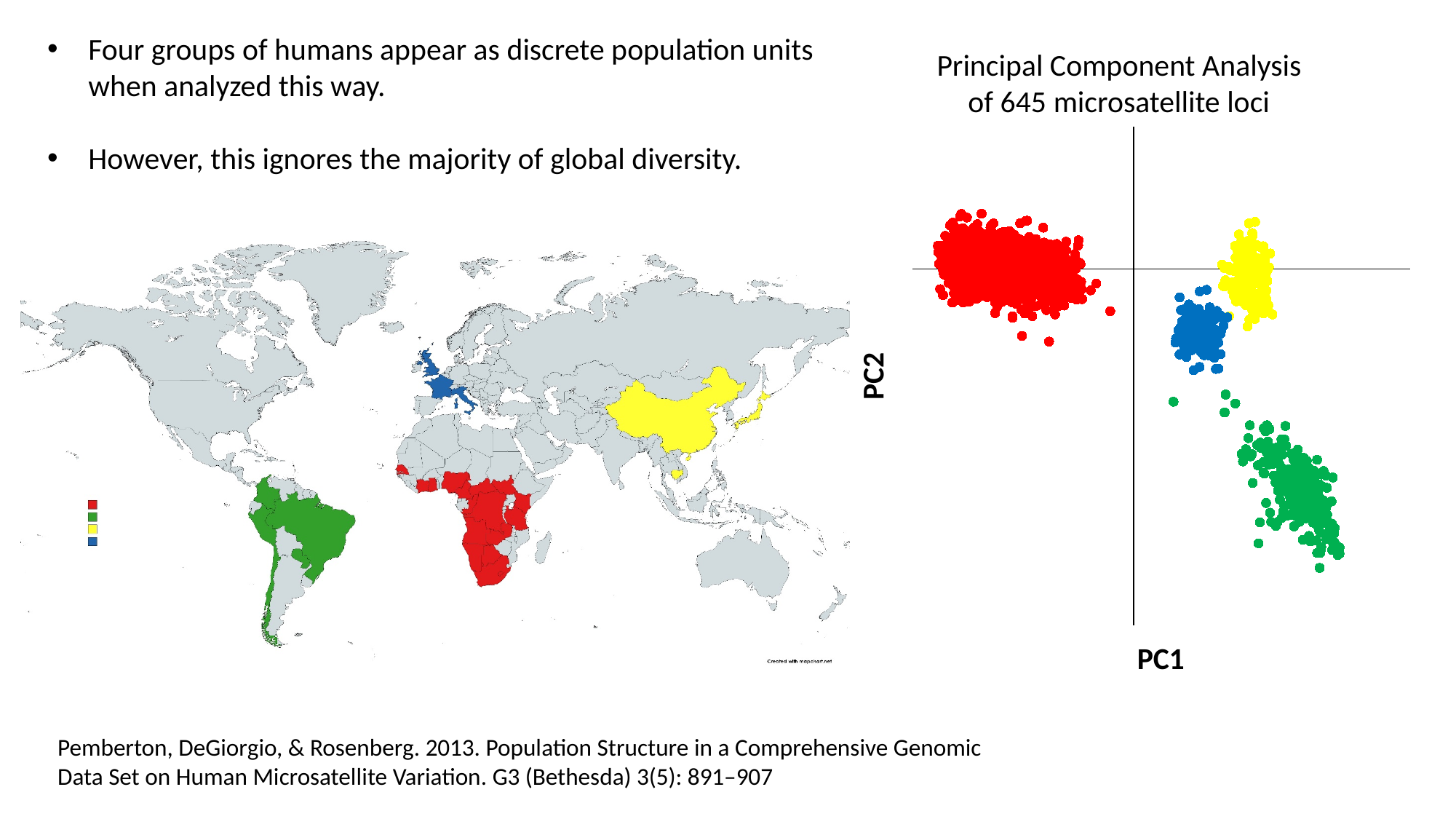
What kind of chart is the Principal Component Analysis chart on the right of the slide? scatter plot What is the label of the horizontal axis of the Principal Component Analysis scatter plot? PC1 How many distinct coloured clusters of points are shown in the Principal Component Analysis scatter plot? 4 In the Principal Component Analysis scatter plot, which cluster is larger in spread, the red cluster or the blue cluster? red How many microsatellite loci does the title of the scatter plot say were analysed? 645 What is the title of the scatter plot on the right of the slide? Principal Component Analysis of 645 microsatellite loci In the Principal Component Analysis scatter plot, which coloured cluster is furthest to the right along the PC1 axis? green In the Principal Component Analysis scatter plot, which coloured cluster lies entirely to the left of the vertical axis? red In the Principal Component Analysis scatter plot, which coloured cluster is lowest along the PC2 axis? green In the Principal Component Analysis scatter plot, is the blue cluster above or below the horizontal axis? below